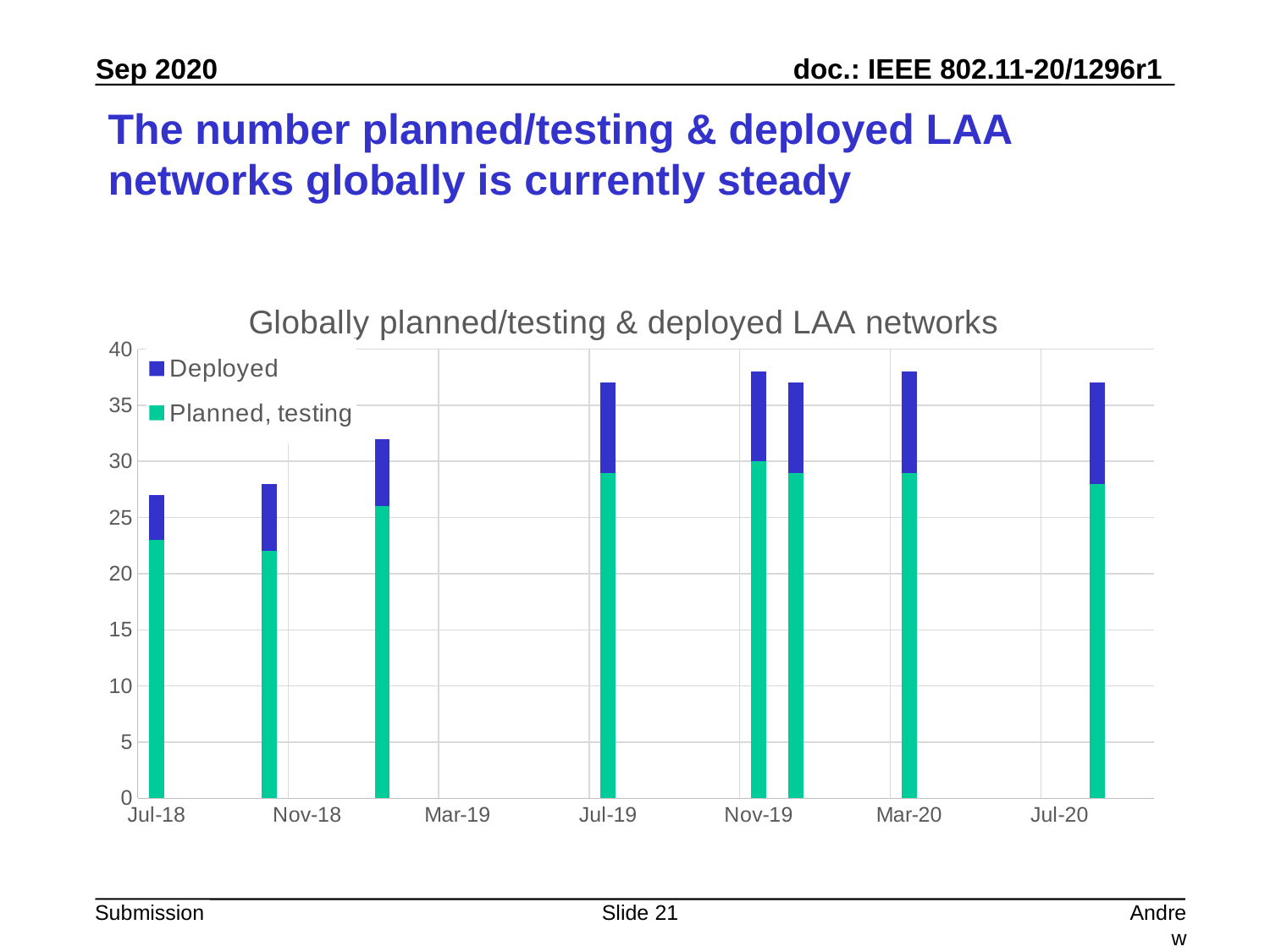
What are the two series named in the legend? Deployed; Planned, testing Is the 'Planned, testing' value at Jul-20 greater or less than 30? less Is the 'Planned, testing' value at Jul-18 greater or less than 25? less What is the title of the chart? Globally planned/testing & deployed LAA networks Is the total height of the bar at Jul-19 greater or less than 35? greater Do the total bar heights rise or fall from Jul-18 to Jul-19? rise How many series does the legend list? 2 How many bars are plotted in the chart? 8 What kind of chart is shown on the slide? Stacked bar chart Which bar is taller in total, Jul-18 or Jul-19? Jul-19